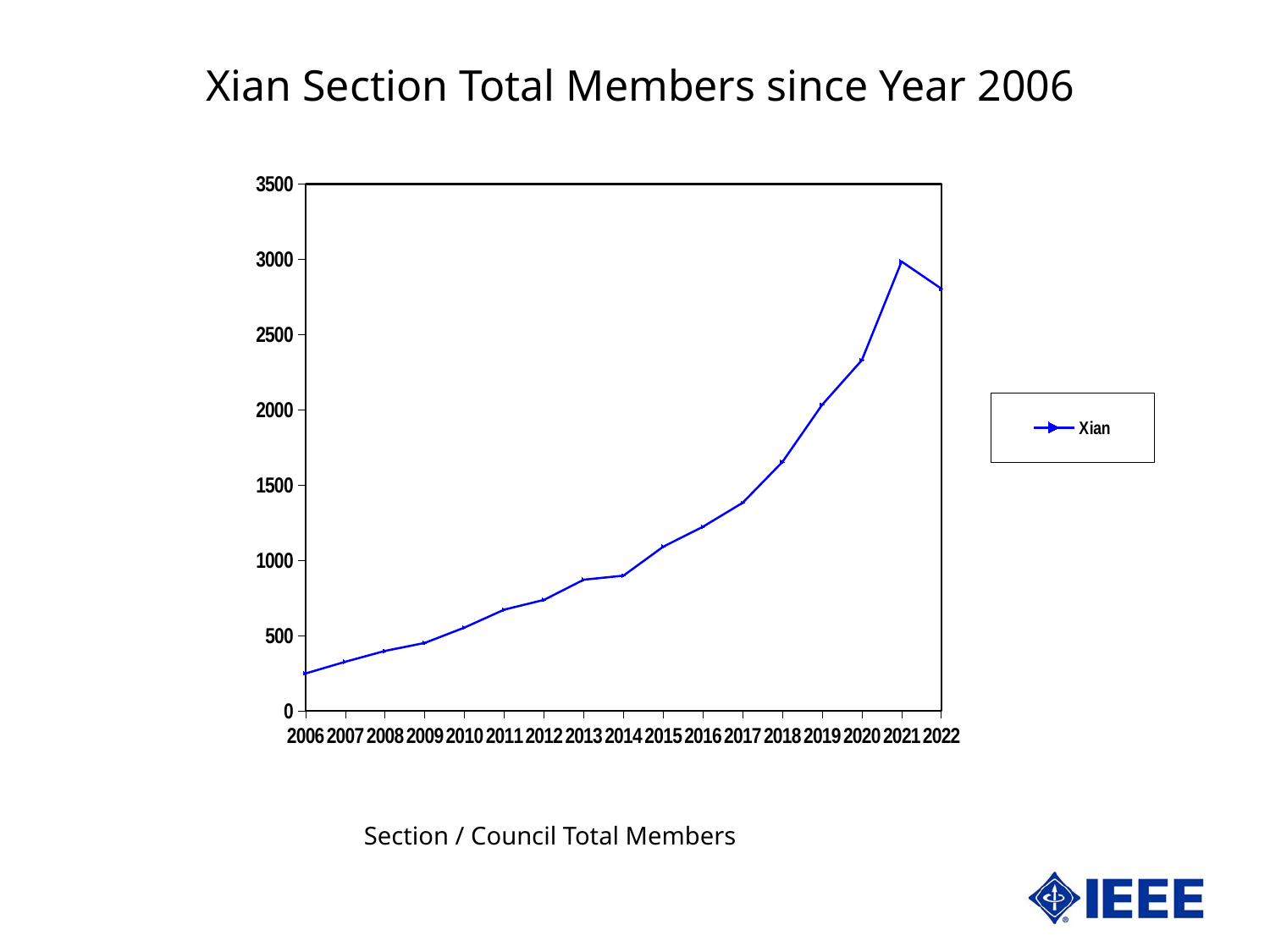
Do the values generally rise or fall from 2006 to 2021? rise Which year has more members, 2021 or 2022? 2021 What kind of chart is shown on the slide? Line chart In which year is the number of Xian members lowest? 2006 How many years are plotted along the x axis? 17 How many series does the legend list? 1 What is the name of the series shown in the legend? Xian In which year is the number of Xian members highest? 2021 Is the value for 2006 greater or less than 500? less Is the value for 2017 greater or less than 1500? less Is the value for 2021 greater or less than 2500? greater What is the title of the chart? Xian Section Total Members since Year 2006